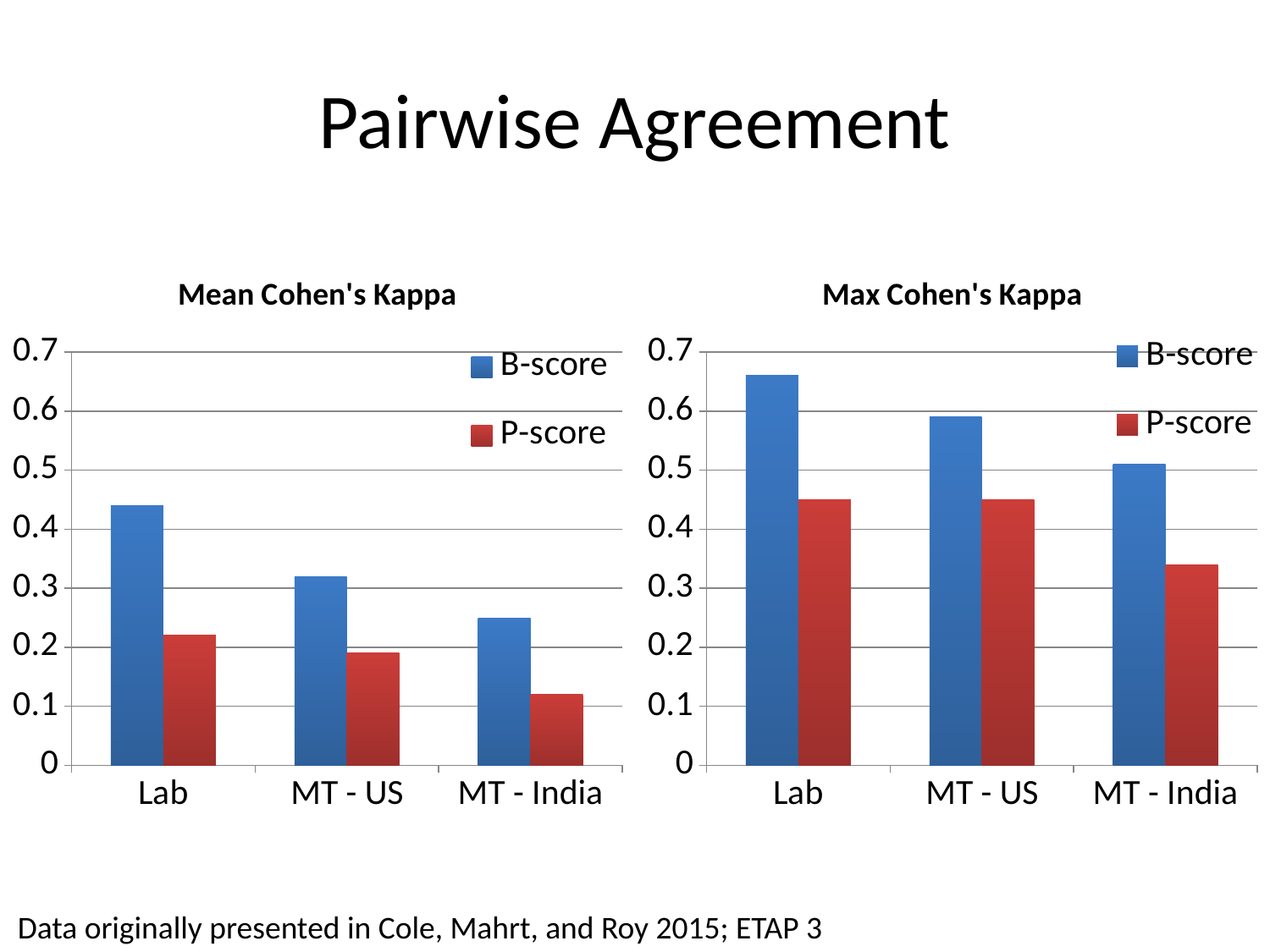
In the Mean Cohen's Kappa chart, is the P-score for MT - India greater or less than 0.2? less How many series does the legend of the Max Cohen's Kappa chart list? 2 In the Mean Cohen's Kappa chart, which category has the highest B-score? Lab In the Max Cohen's Kappa chart, which is larger for MT - US: the B-score or the P-score? B-score In the Mean Cohen's Kappa chart, is the B-score for Lab greater or less than 0.4? greater In the Max Cohen's Kappa chart, is the B-score for Lab greater or less than 0.6? greater In the Mean Cohen's Kappa chart, which category has the lowest P-score? MT - India In the Max Cohen's Kappa chart, which category has the lowest B-score? MT - India How many categories are shown on the x axis of the Mean Cohen's Kappa chart? 3 In the Mean Cohen's Kappa chart, do the B-score values rise or fall from Lab to MT - India? fall What type of chart is the Mean Cohen's Kappa chart? bar chart